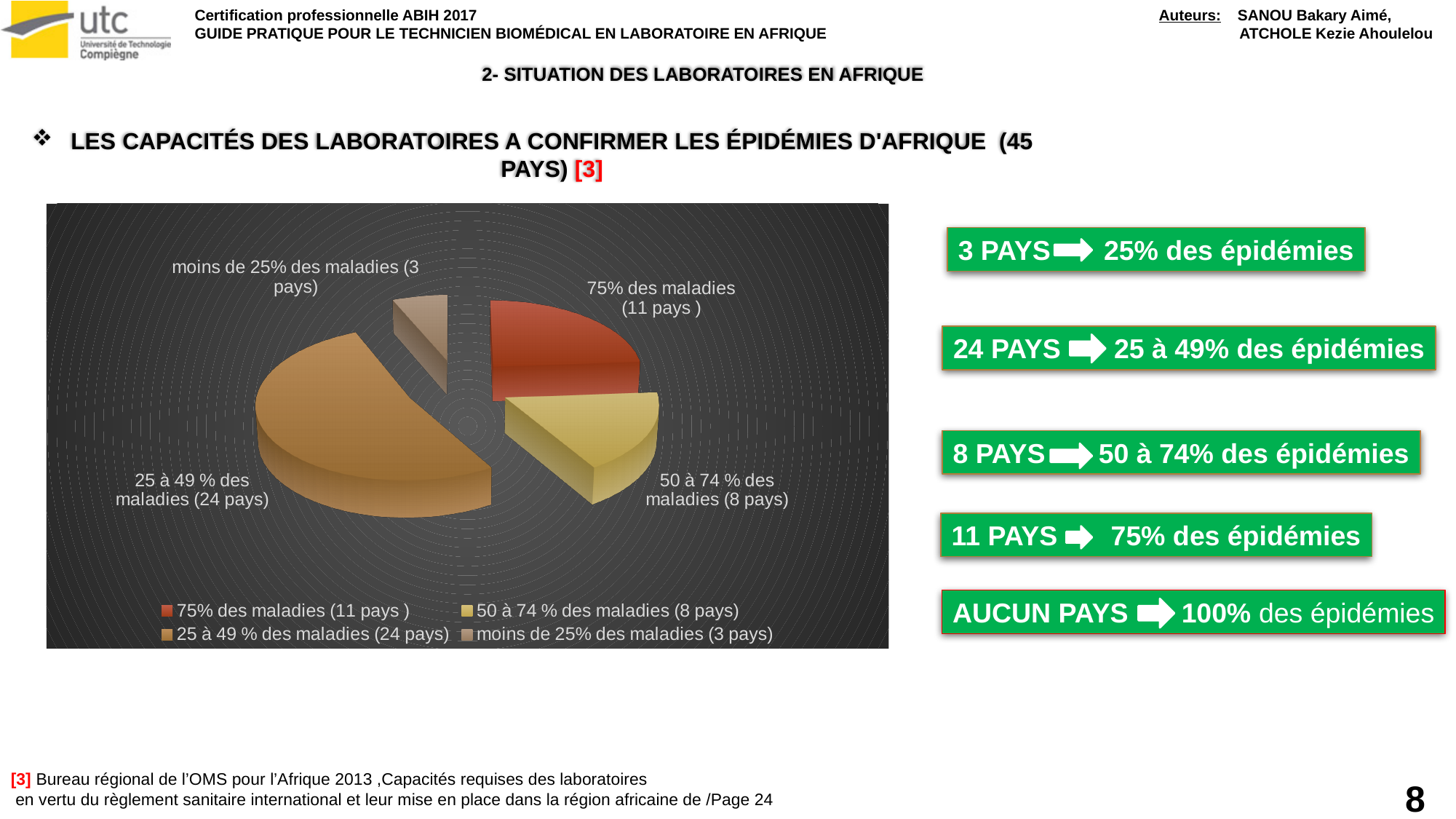
According to the pie chart, how many countries can confirm moins de 25% des maladies? 3 pays What kind of chart is shown on the slide? pie chart Which category in the pie chart has the largest number of countries? 25 à 49 % des maladies (24 pays) According to the pie chart, how many countries can confirm 75% des maladies? 11 pays How many entries does the legend of the pie chart list? 4 According to the pie chart, how many countries can confirm 50 à 74 % des maladies? 8 pays Which category in the pie chart has the smallest number of countries? moins de 25% des maladies (3 pays) How many more countries are in the '25 à 49 % des maladies' category than in the '75% des maladies' category? 13 What colour is the slice for '75% des maladies (11 pays)' in the pie chart? red How many slices does the pie chart have? 4 According to the pie chart, how many countries can confirm 25 à 49 % des maladies? 24 pays Which category has more countries: '75% des maladies' or '50 à 74 % des maladies'? 75% des maladies (11 pays)